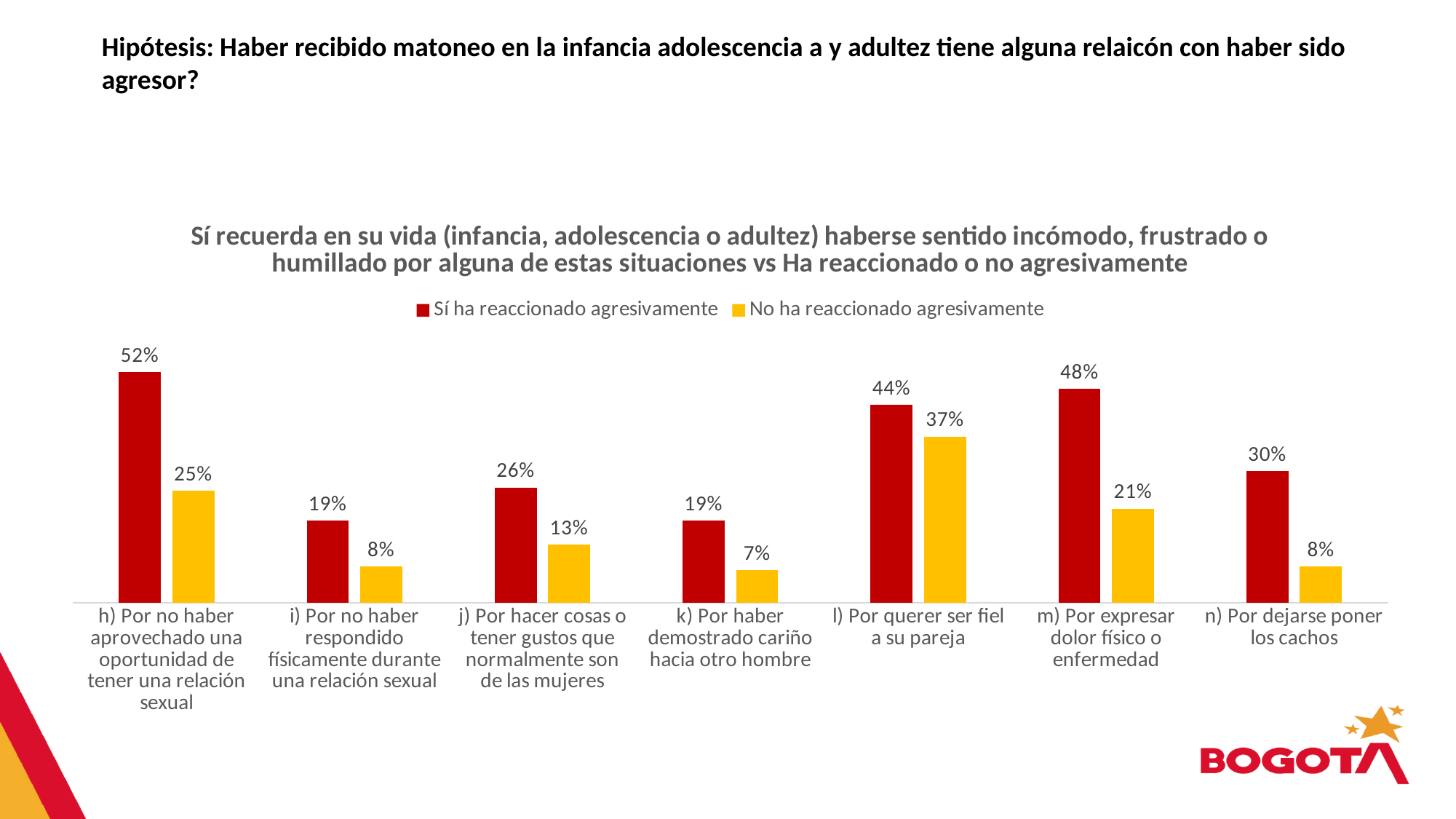
How many series does the legend list? 2 What is the value for 'Sí ha reaccionado agresivamente' in category 'h) Por no haber aprovechado una oportunidad de tener una relación sexual'? 52% What kind of chart is shown on the slide? Bar chart What is the difference between the two series in category 'm) Por expresar dolor físico o enfermedad'? 27 percentage points Which category has the highest value for 'Sí ha reaccionado agresivamente'? h) Por no haber aprovechado una oportunidad de tener una relación sexual What is the value for 'Sí ha reaccionado agresivamente' in category 'n) Por dejarse poner los cachos'? 30% What is the value for 'No ha reaccionado agresivamente' in category 'l) Por querer ser fiel a su pareja'? 37% How many categories are shown on the x axis? 7 Which colour represents the series 'Sí ha reaccionado agresivamente'? Red Which category has the lowest value for 'No ha reaccionado agresivamente'? k) Por haber demostrado cariño hacia otro hombre Which is larger: 'Sí ha reaccionado agresivamente' for 'j) Por hacer cosas o tener gustos que normalmente son de las mujeres' or 'No ha reaccionado agresivamente' for 'l) Por querer ser fiel a su pareja'? No ha reaccionado agresivamente for l) Por querer ser fiel a su pareja What is the value for 'No ha reaccionado agresivamente' in category 'i) Por no haber respondido físicamente durante una relación sexual'? 8%